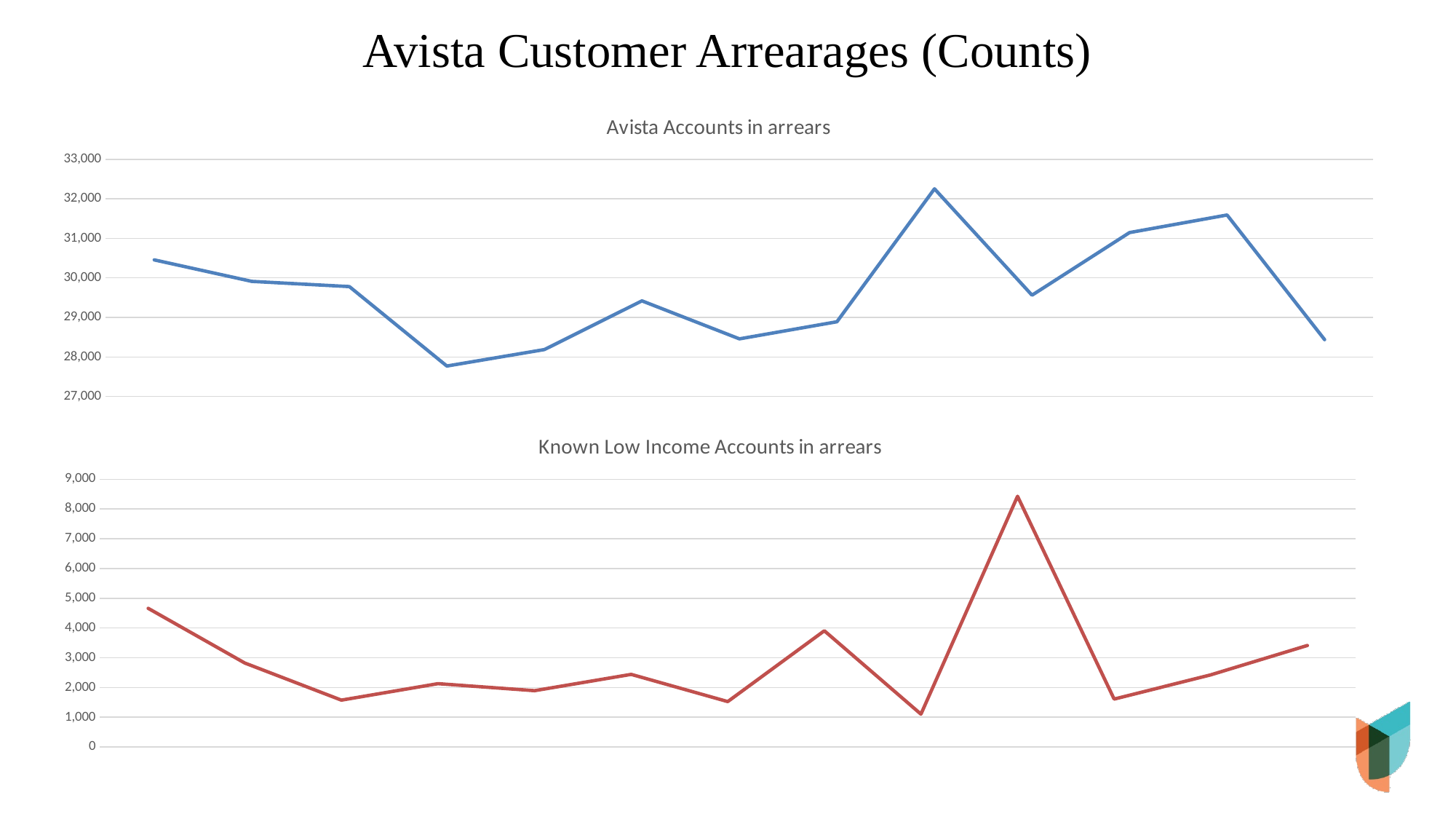
What kind of chart is the 'Known Low Income Accounts in arrears' chart? line chart What colour is the line in the 'Known Low Income Accounts in arrears' chart? red In the 'Known Low Income Accounts in arrears' chart, is the first point on the line greater or less than 4,000? greater In the 'Avista Accounts in arrears' chart, does the line rise or fall between the first point and the fourth point? fall In the 'Known Low Income Accounts in arrears' chart, which is higher, the first point or the last point on the line? the first point How many data points are plotted on the 'Known Low Income Accounts in arrears' line? 13 In the 'Known Low Income Accounts in arrears' chart, is the highest point on the line greater or less than 8,000? greater What kind of chart is the 'Avista Accounts in arrears' chart? line chart How many data points are plotted on the 'Avista Accounts in arrears' line? 13 In the 'Avista Accounts in arrears' chart, is the first point on the line greater or less than 30,000? greater